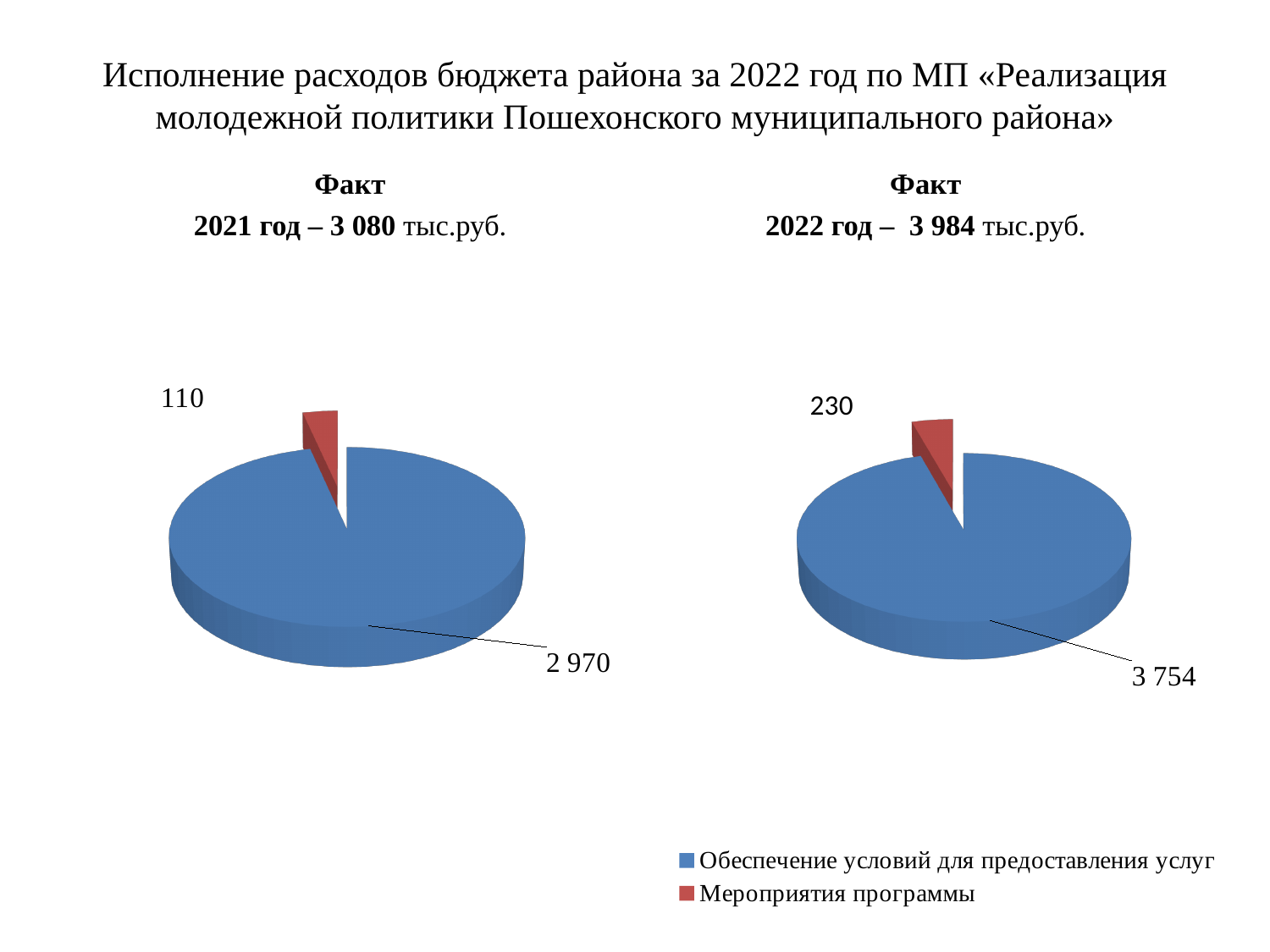
In the right (2022) pie chart, which category has the largest slice? Обеспечение условий для предоставления услуг What colour represents Мероприятия программы in the pie charts? red How many entries does the legend list? 2 In the right (2022) pie chart, what is the difference between Обеспечение условий для предоставления услуг and Мероприятия программы? 3 524 In the left (2021) pie chart, what is the value for Мероприятия программы? 110 Which is larger: the value for Мероприятия программы in the 2021 chart or in the 2022 chart? 2022 chart How many slices does the left (2021) pie chart have? 2 In the right (2022) pie chart, what is the value for Мероприятия программы? 230 In the right (2022) pie chart, what is the value for Обеспечение условий для предоставления услуг? 3 754 In the left (2021) pie chart, which category has the smallest slice? Мероприятия программы What type of chart is used on the left (2021) chart? pie chart In the left (2021) pie chart, what is the value for Обеспечение условий для предоставления услуг? 2 970